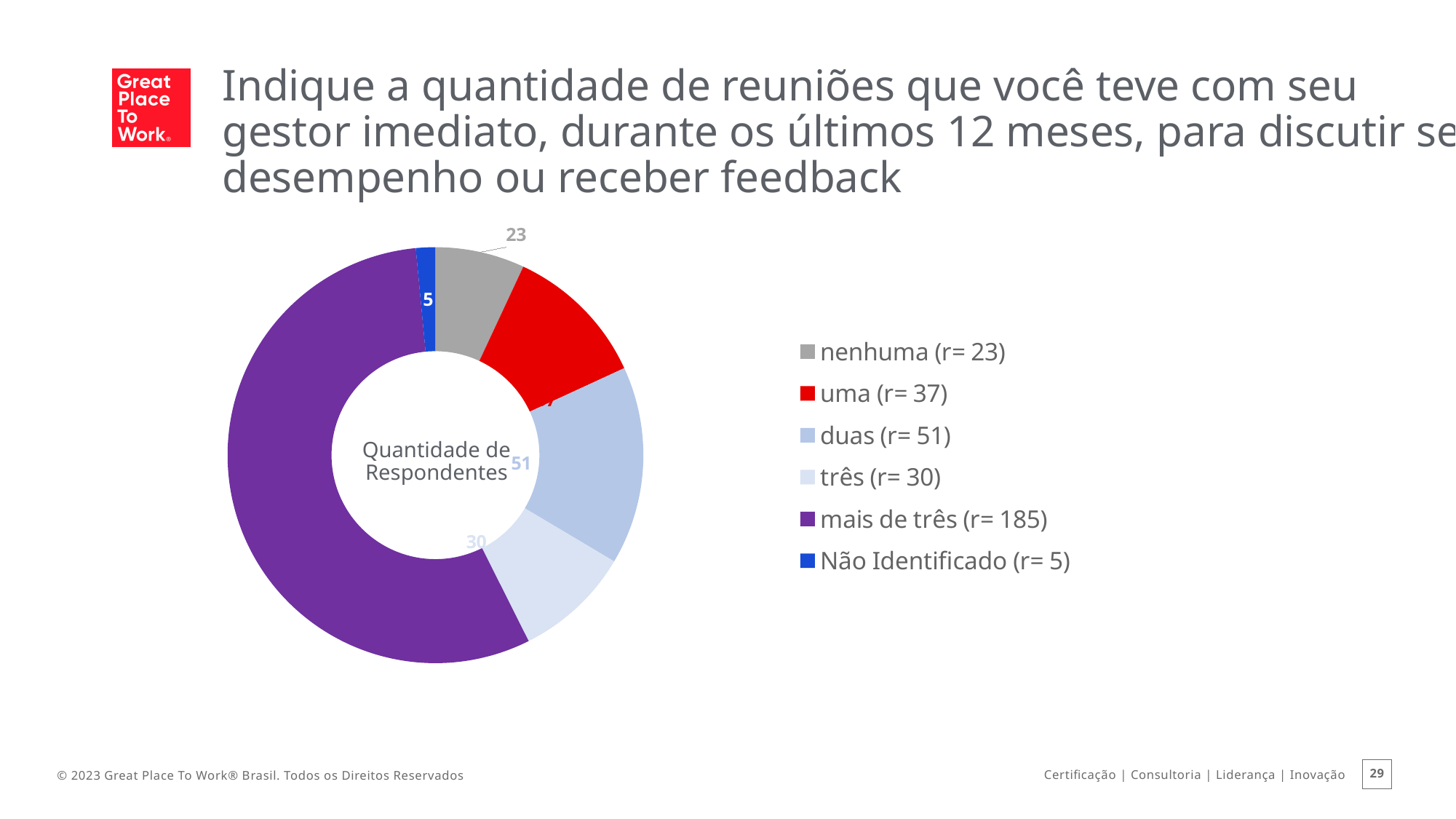
What kind of chart is shown on the slide? Doughnut (pie) chart How many respondents are in the 'duas' category? 51 How many respondents are in the 'nenhuma' category? 23 Which category has the smallest number of respondents? Não Identificado Which category has the largest number of respondents? mais de três How many respondents are in the 'Não Identificado' category? 5 What text is shown in the centre of the doughnut chart? Quantidade de Respondentes How many categories does the legend list? 6 What is the difference between the number of respondents for 'duas' and 'uma'? 14 Which has more respondents, 'três' or 'nenhuma'? três What is the total number of respondents across all categories? 331 How many respondents are in the 'mais de três' category? 185